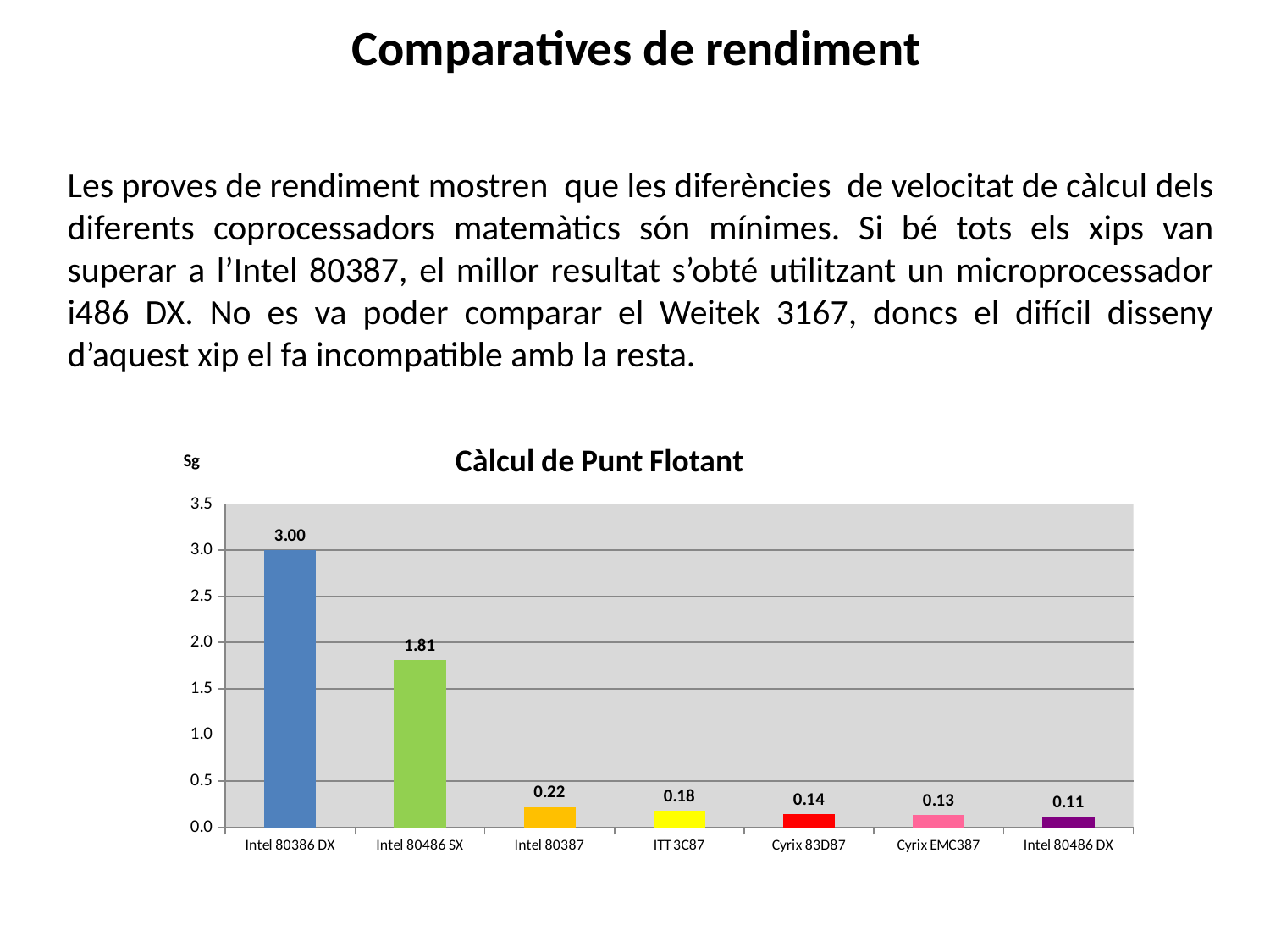
Which category has the lowest value? Intel 80486 DX Is the value for Intel 80486 SX greater or less than 1.5? greater What is the value for Cyrix 83D87? 0.14 What is the value for Intel 80386 DX? 3.00 Which is larger, the value for Intel 80387 or the value for ITT 3C87? Intel 80387 What is the value for Intel 80486 SX? 1.81 What kind of chart is shown? bar chart How many categories are shown on the x axis? 7 What is the title of the chart? Càlcul de Punt Flotant What is the difference between the values for Intel 80386 DX and Intel 80486 SX? 1.19 What is the value for Intel 80486 DX? 0.11 Which category has the highest value? Intel 80386 DX